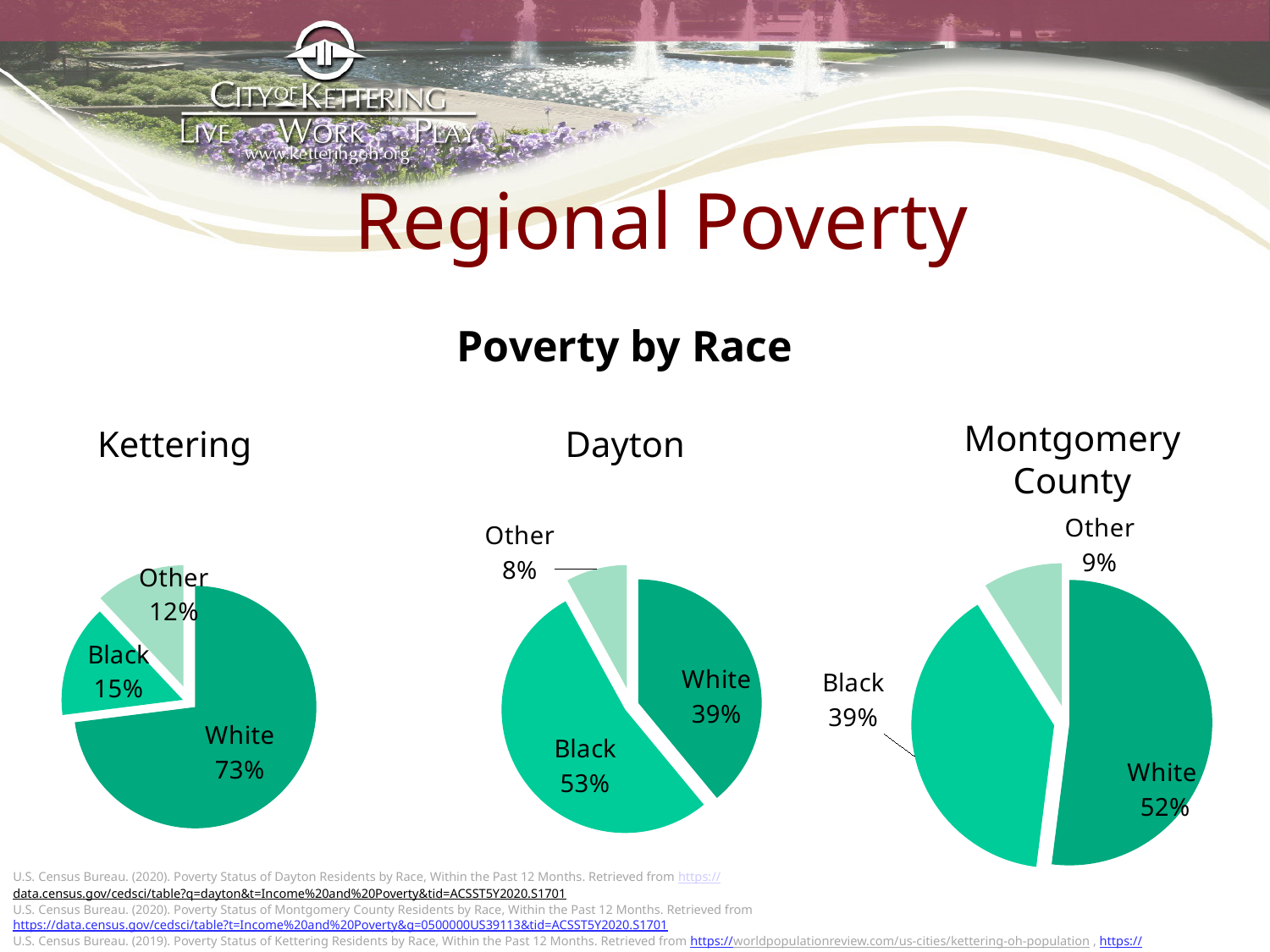
What kind of chart is the Kettering chart? Pie chart In the Kettering chart, which category has the smallest slice? Other In the Dayton chart, what is the value for Black? 53% In the Kettering chart, what share of the pie is White? 73% How many categories does the Dayton chart show? 3 In the Dayton chart, which category has the largest slice? Black How many charts are shown on the slide under the heading Poverty by Race? 3 In the Kettering chart, what is the difference between the White and Black values? 58% In the Montgomery County chart, which category has the largest slice? White In the Montgomery County chart, which is larger, White or Black? White In the Dayton chart, what is the difference between the Black and White values? 14% In the Montgomery County chart, what is the value for Other? 9%